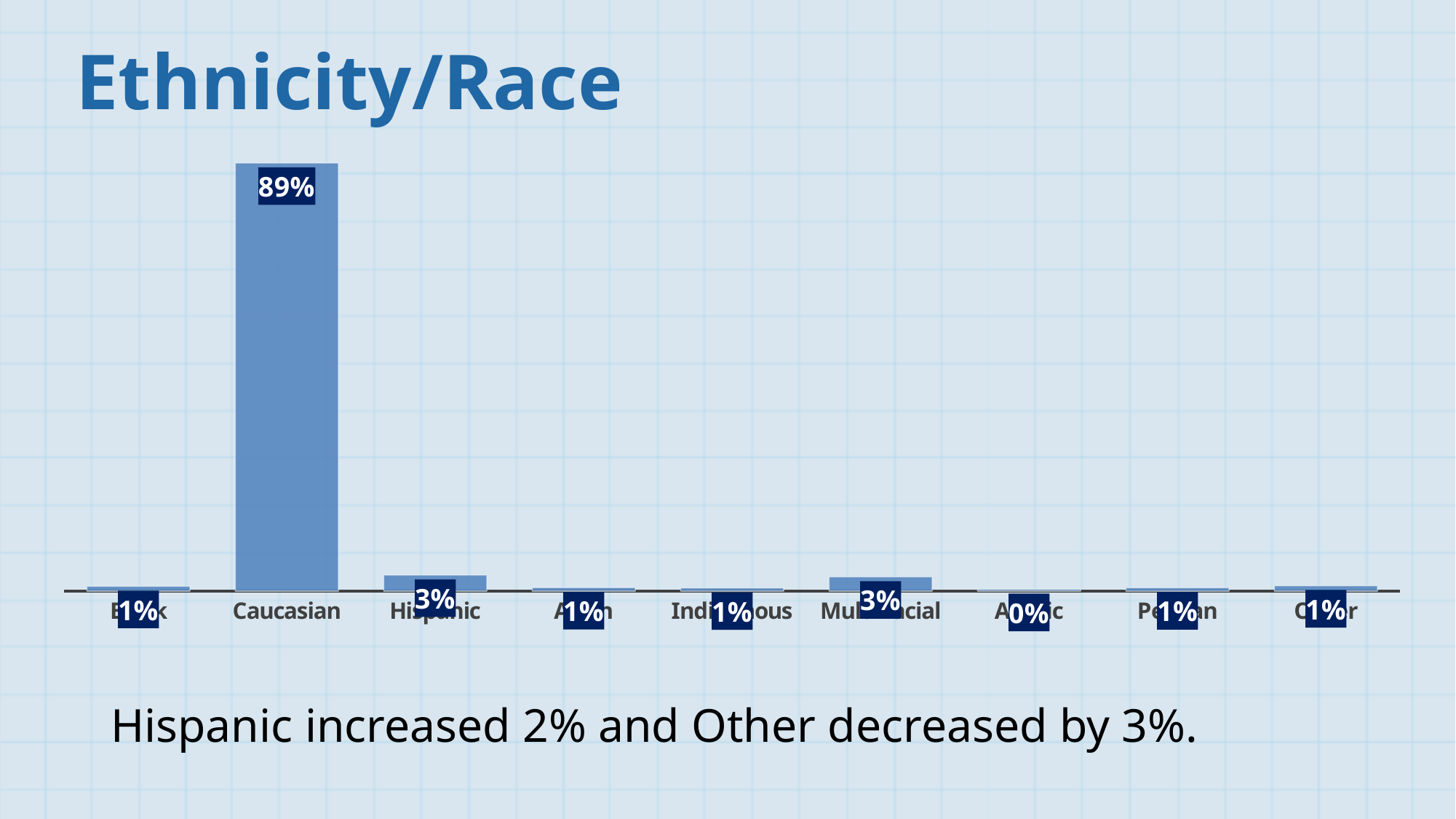
What is the difference between the values for Caucasian and Hispanic? 86% Which category has the highest value? Caucasian What is the value for Other? 1% What kind of chart is shown on the slide? bar chart What is the value for Indigenous? 1% How many categories are shown on the chart? 9 What is the title of the chart? Ethnicity/Race What is the value for Multiracial? 3% What is the lowest value shown on the chart? 0% Which is larger, the value for Hispanic or the value for Indigenous? Hispanic What is the value for Caucasian? 89% What is the value for Hispanic? 3%